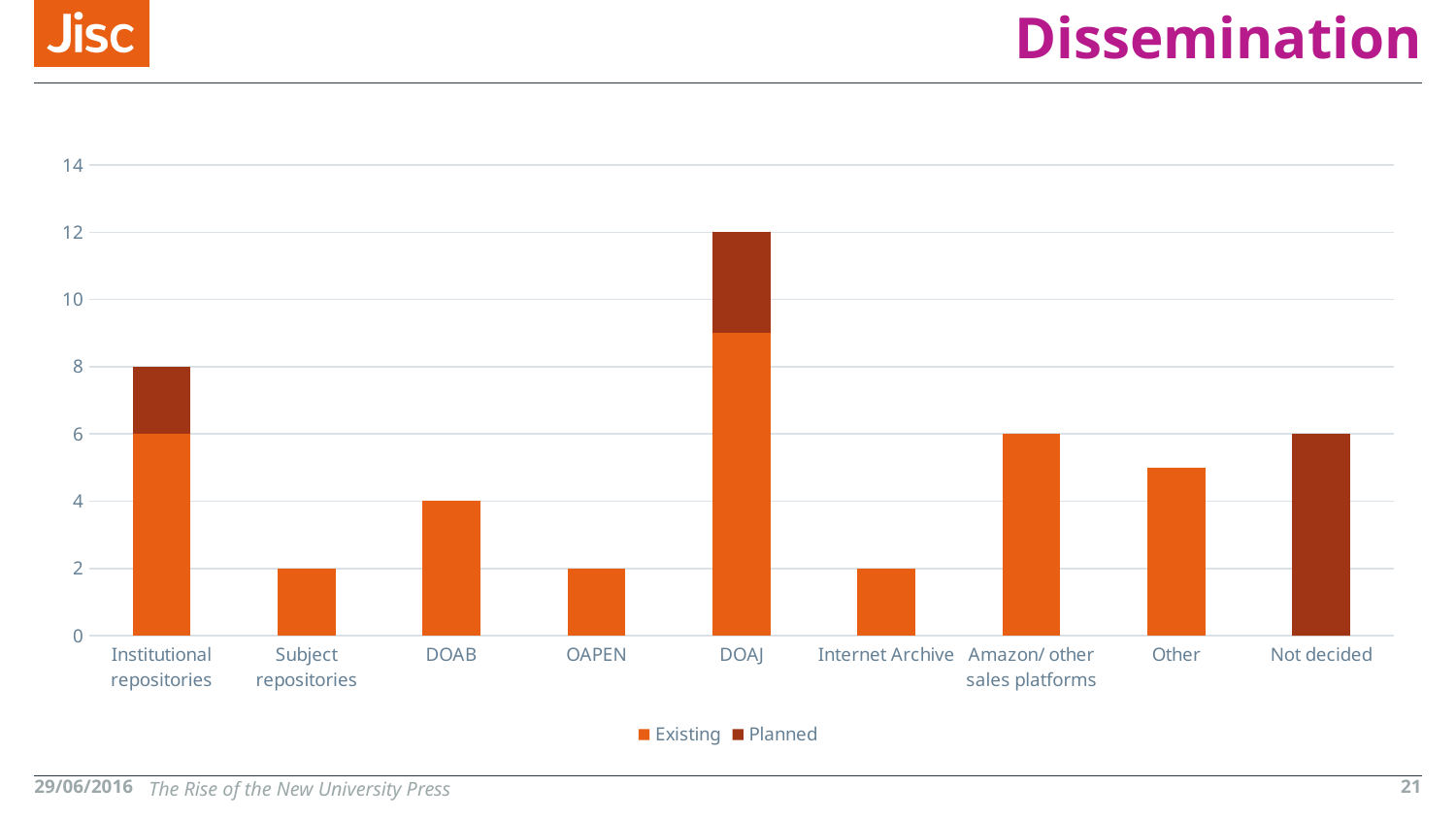
Is the Existing value for DOAJ greater or less than 8? greater Is the value for Other greater or less than 6? less What is the Existing value for Amazon/ other sales platforms? 6 Which series is shown for the Not decided category? Planned What is the Existing value for Institutional repositories? 6 What is the total height of the stacked bar for DOAJ? 12 How many categories are shown on the x axis? 9 What kind of chart is shown on the slide? Stacked bar chart How many series does the legend list? 2 Which category has the highest total bar? DOAJ What is the Existing value for DOAB? 4 What is the total height of the stacked bar for Institutional repositories? 8